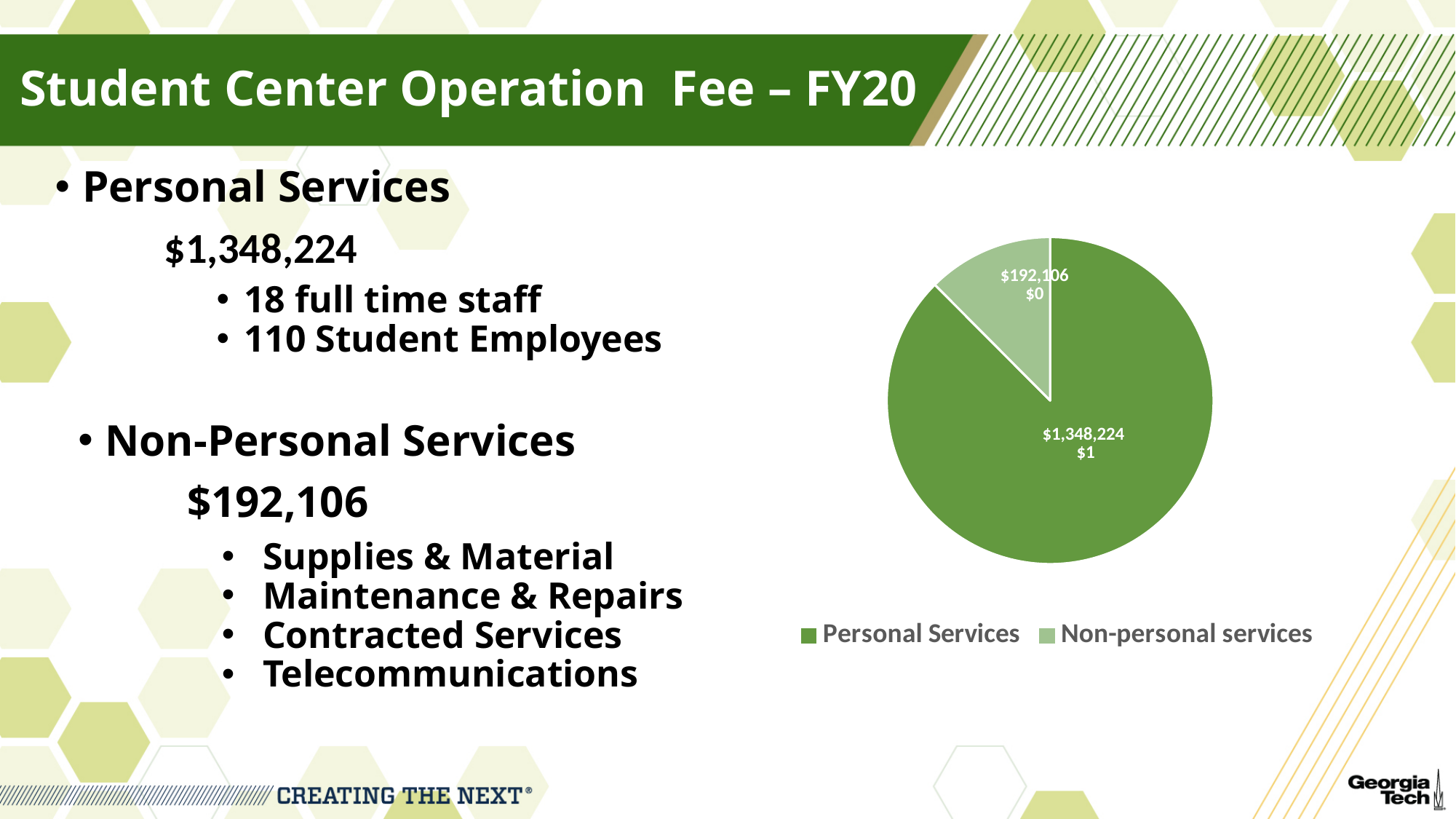
What value is shown for the Non-personal services slice of the pie chart? $192,106 How many entries does the pie chart legend list? 2 What is the difference between the Personal Services value and the Non-personal services value in the pie chart? $1,156,118 What kind of chart is shown on the slide? Pie chart How many slices does the pie chart have? 2 What are the two legend entries of the pie chart? Personal Services and Non-personal services Which slice of the pie chart is the largest? Personal Services Which is larger in the pie chart, Personal Services or Non-personal services? Personal Services What is the total of the two values shown in the pie chart? $1,540,330 What value is shown for the Personal Services slice of the pie chart? $1,348,224 What colour is the Personal Services slice in the pie chart? Dark green Which slice of the pie chart is the smallest? Non-personal services